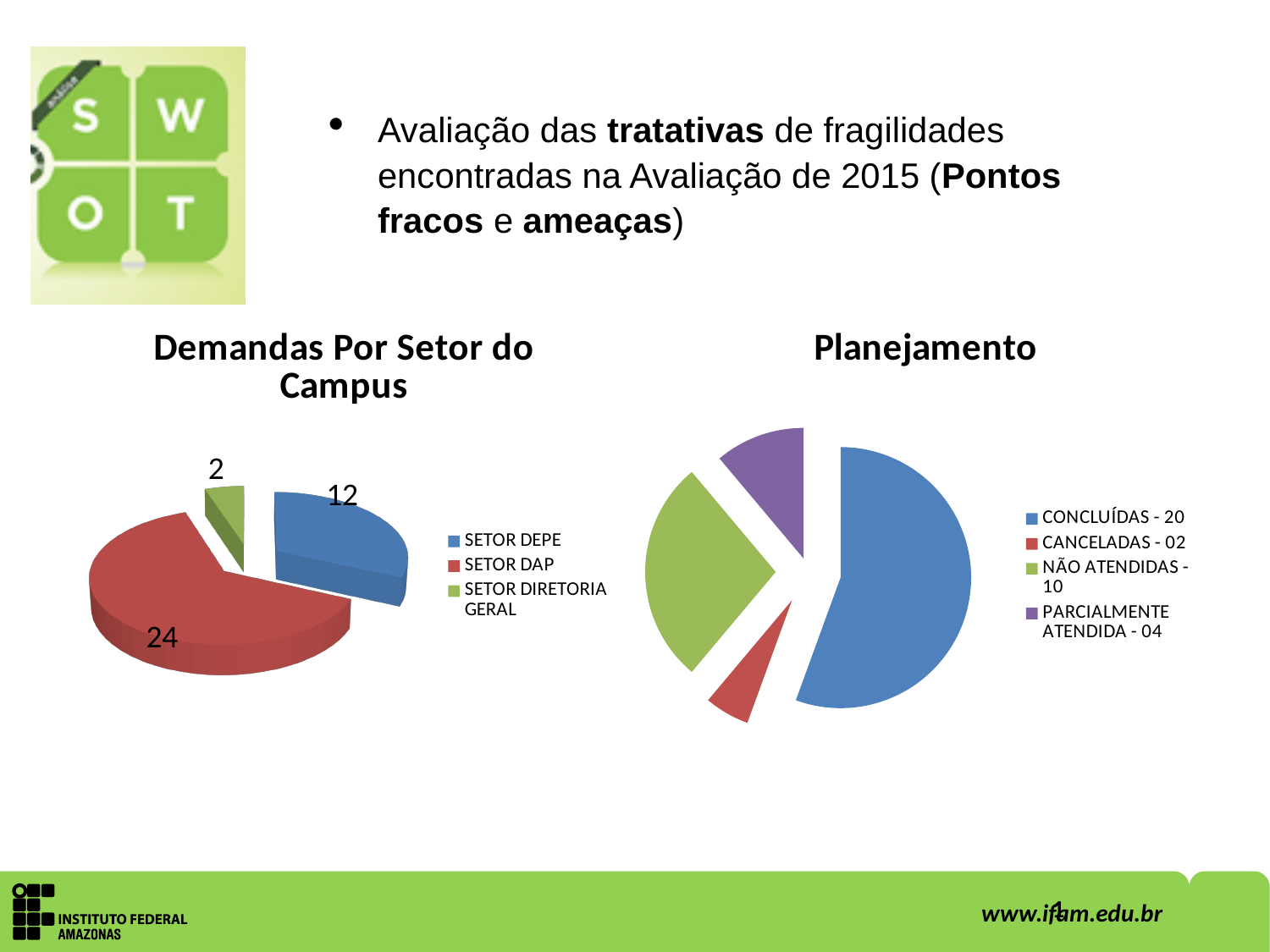
In the 'Planejamento' chart, what is the value for NÃO ATENDIDAS according to the legend? 10 In the 'Demandas Por Setor do Campus' chart, which sector has the smallest slice? SETOR DIRETORIA GERAL In the 'Demandas Por Setor do Campus' chart, what is the difference between the values for SETOR DAP and SETOR DEPE? 12 In the 'Demandas Por Setor do Campus' chart, what is the value for SETOR DAP? 24 In the 'Planejamento' chart, how many items does the legend list? 4 What type of chart is the 'Planejamento' chart? Pie chart In the 'Planejamento' chart, what colour is the CANCELADAS slice? Red In the 'Demandas Por Setor do Campus' chart, how many sectors are shown? 3 In the 'Planejamento' chart, which category has the largest slice? CONCLUÍDAS - 20 In the 'Demandas Por Setor do Campus' chart, which sector has the largest slice? SETOR DAP In the 'Demandas Por Setor do Campus' chart, what is the value for SETOR DEPE? 12 In the 'Planejamento' chart, which is larger: CONCLUÍDAS or NÃO ATENDIDAS? CONCLUÍDAS